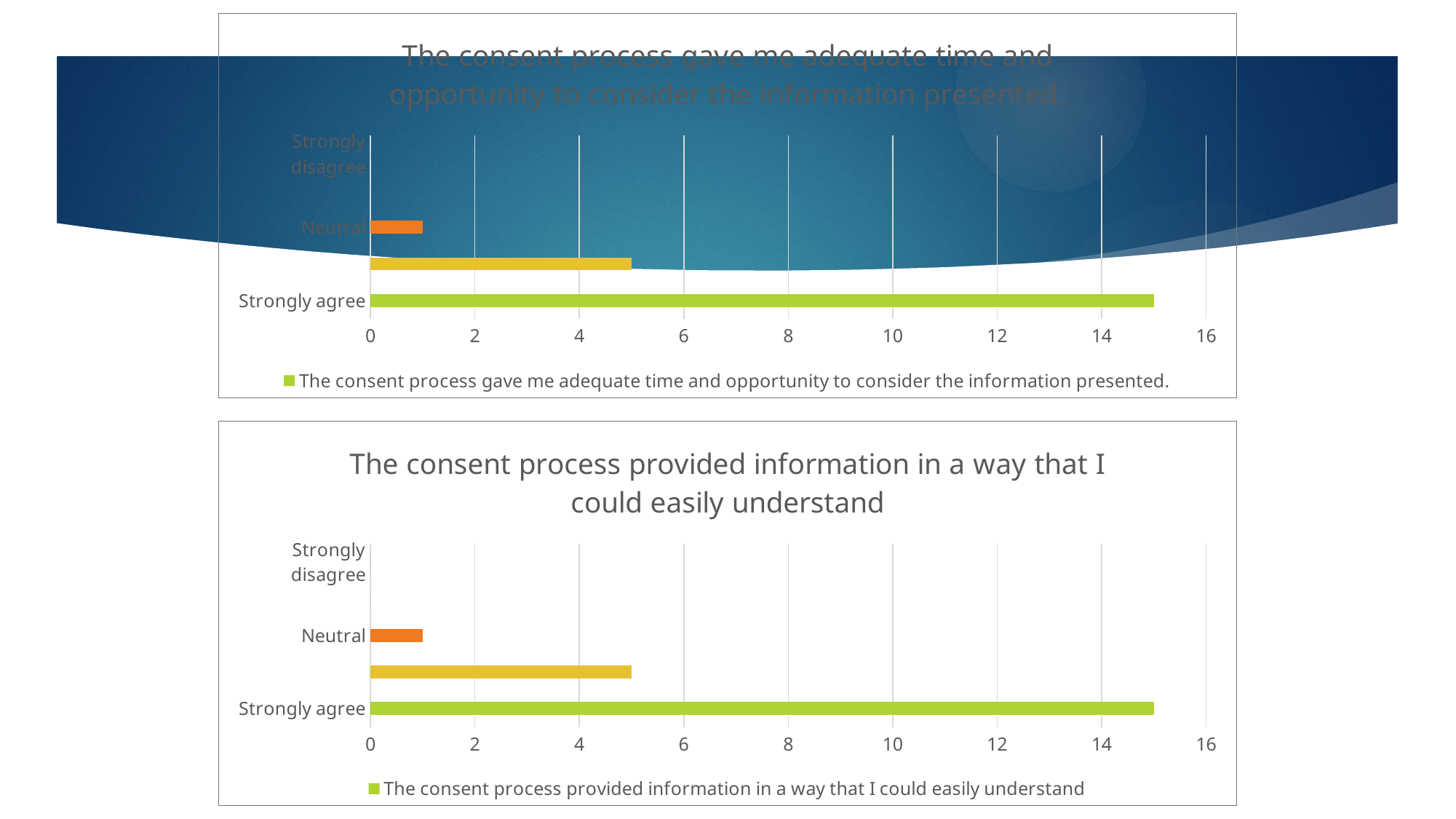
In the top chart, which category has the highest value? Strongly agree In the top chart, is the value for Strongly agree greater or less than 14? greater In the bottom chart, which is larger: the value for Neutral or the value for Strongly agree? Strongly agree How many series does the legend of the top chart list? 1 In the top chart, is the value for Neutral greater or less than 2? less What kind of chart is the bottom chart, titled 'The consent process provided information in a way that I could easily understand'? Bar chart What kind of chart is the top chart, titled 'The consent process gave me adequate time and opportunity to consider the information presented.'? Bar chart In the bottom chart, is the value for Strongly agree greater or less than 12? greater What is the legend entry shown below the bottom chart? The consent process provided information in a way that I could easily understand In the bottom chart, which category has the highest value? Strongly agree In the top chart, which is larger: the value for Strongly agree or the value for Neutral? Strongly agree